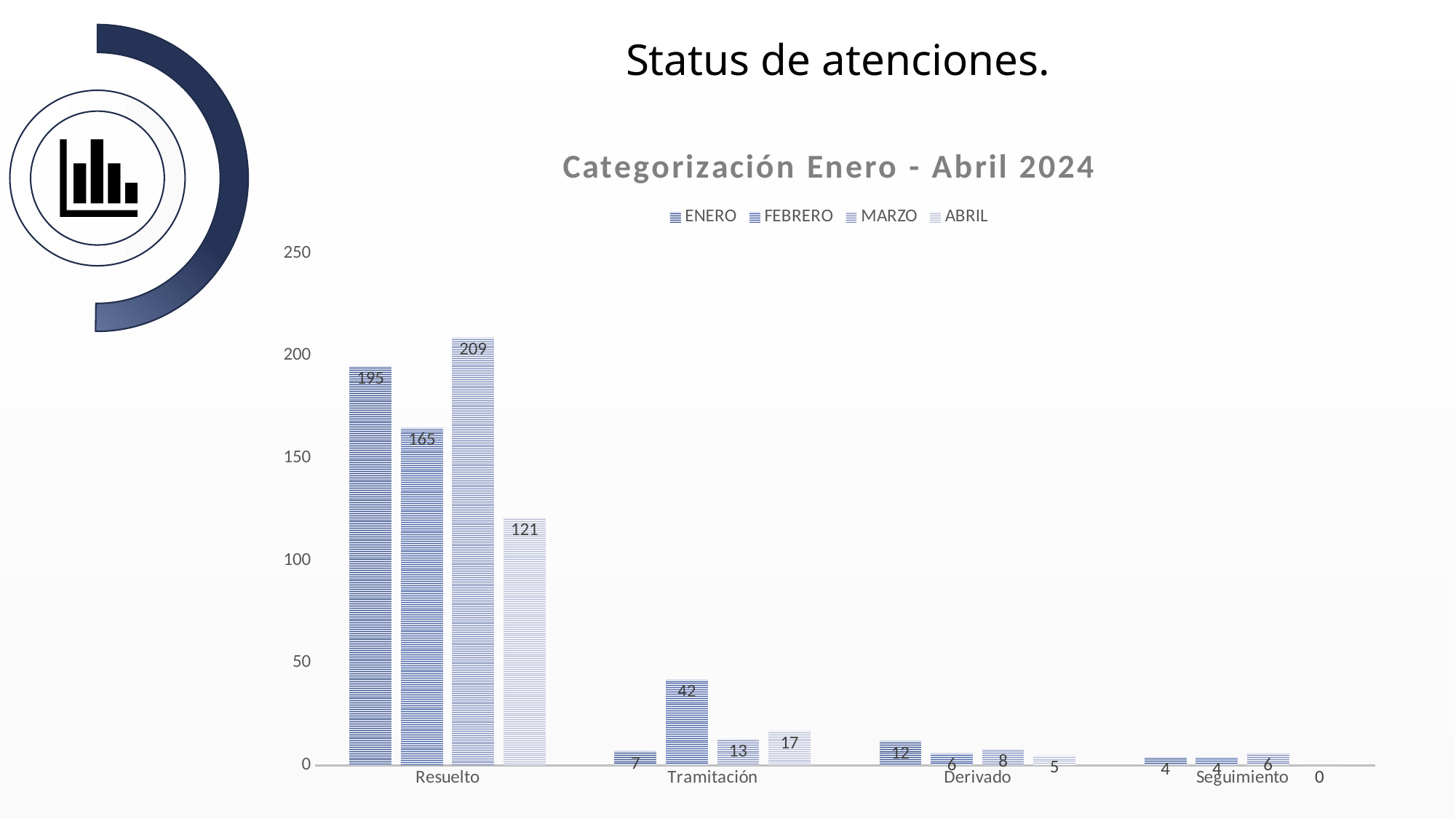
What is the value for MARZO in the Resuelto category? 209 What is the value for ABRIL in the Tramitación category? 17 What kind of chart is shown on the slide? Bar chart Which is larger in the Derivado category, the FEBRERO value or the MARZO value? MARZO How many categories are shown on the x axis? 4 What is the title of the chart? Categorización Enero - Abril 2024 What is the value for ABRIL in the Seguimiento category? 0 What is the difference between the MARZO and FEBRERO values in the Resuelto category? 44 How many series does the legend list? 4 Which month has the lowest value in the Tramitación category? ENERO What is the value for ENERO in the Derivado category? 12 Which month has the highest value in the Resuelto category? MARZO